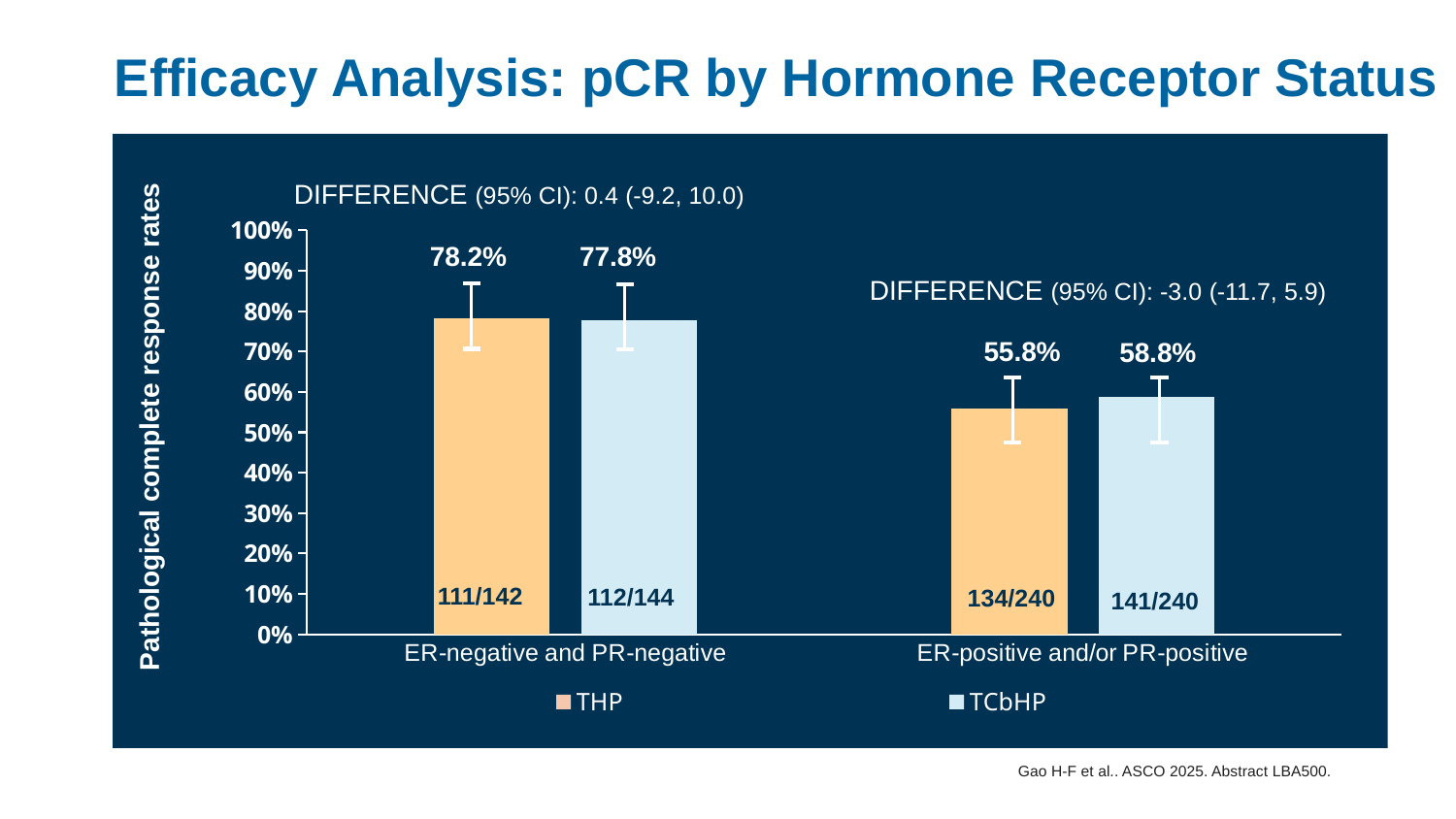
What is the pCR rate for TCbHP in the ER-negative and PR-negative group? 77.8% How many patients achieved pCR out of the total for THP in the ER-negative and PR-negative group, as labelled on the bar? 111/142 What is the pCR rate for THP in the ER-negative and PR-negative group? 78.2% How many hormone receptor status categories are shown on the x axis? 2 Which bar shows the lowest pCR rate on the chart? THP in ER-positive and/or PR-positive (55.8%) What kind of chart is shown on the slide? Bar chart What is the pCR rate for TCbHP in the ER-positive and/or PR-positive group? 58.8% What is the difference in pCR rate between TCbHP and THP in the ER-positive and/or PR-positive group, based on the bar labels? 3.0 percentage points What is the pCR rate for THP in the ER-positive and/or PR-positive group? 55.8% What is the label of the y axis? Pathological complete response rates In the ER-positive and/or PR-positive group, which arm has the higher pCR rate, THP or TCbHP? TCbHP How many series does the legend list? 2